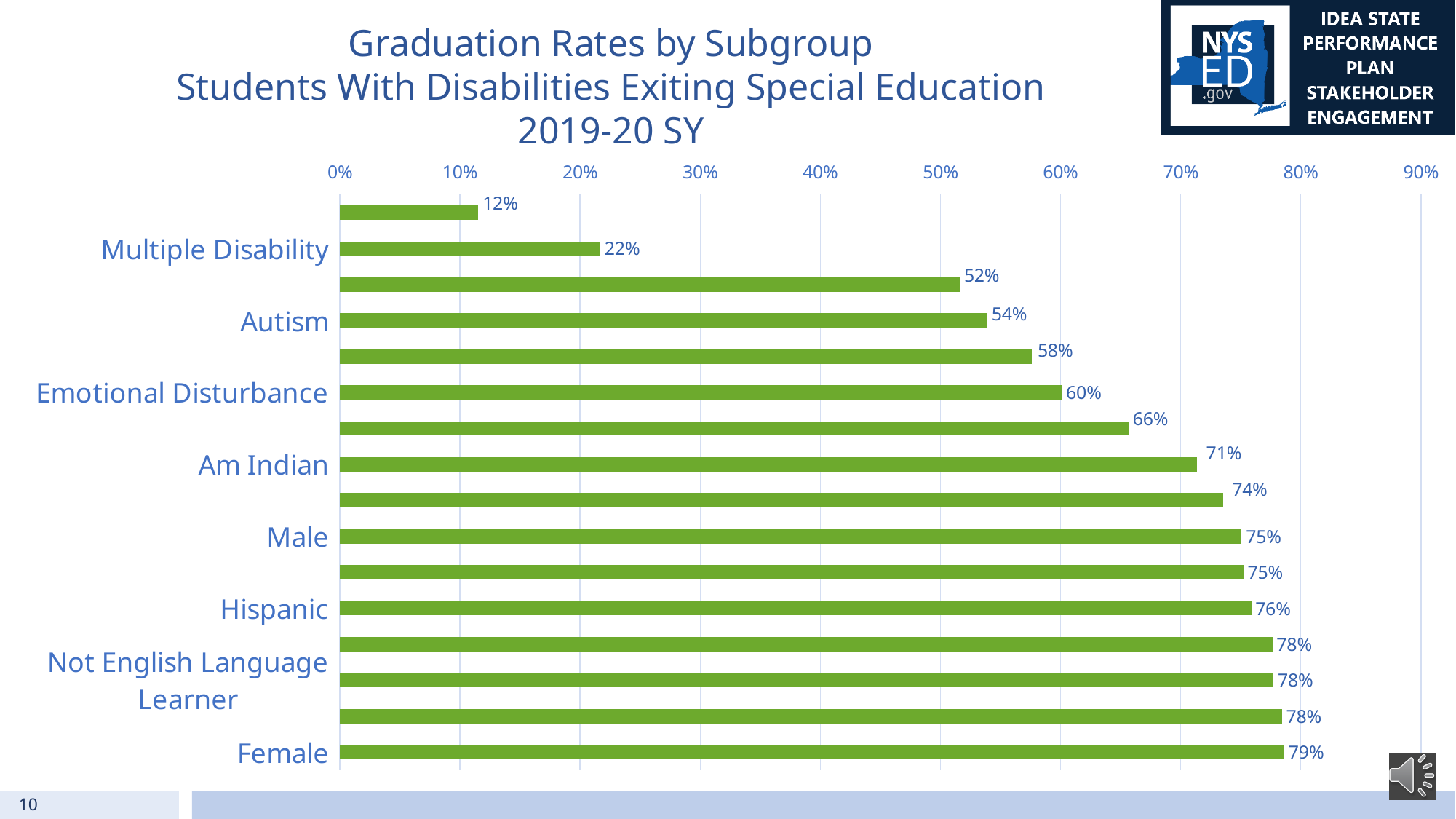
What is the difference between the graduation rates for Female and Multiple Disability? 57 percentage points What is the graduation rate for Female? 79% What is the graduation rate for Emotional Disturbance? 60% What is the lowest graduation rate shown on the chart? 12% What kind of chart is shown on the slide? bar chart How many bars are plotted on the chart? 16 What is the graduation rate for Autism? 54% What is the graduation rate for Multiple Disability? 22% Is the graduation rate for Autism greater or less than 50%? greater Which labeled subgroup has the highest graduation rate? Female What is the graduation rate for Am Indian? 71% Which has a higher graduation rate, Hispanic or Male? Hispanic